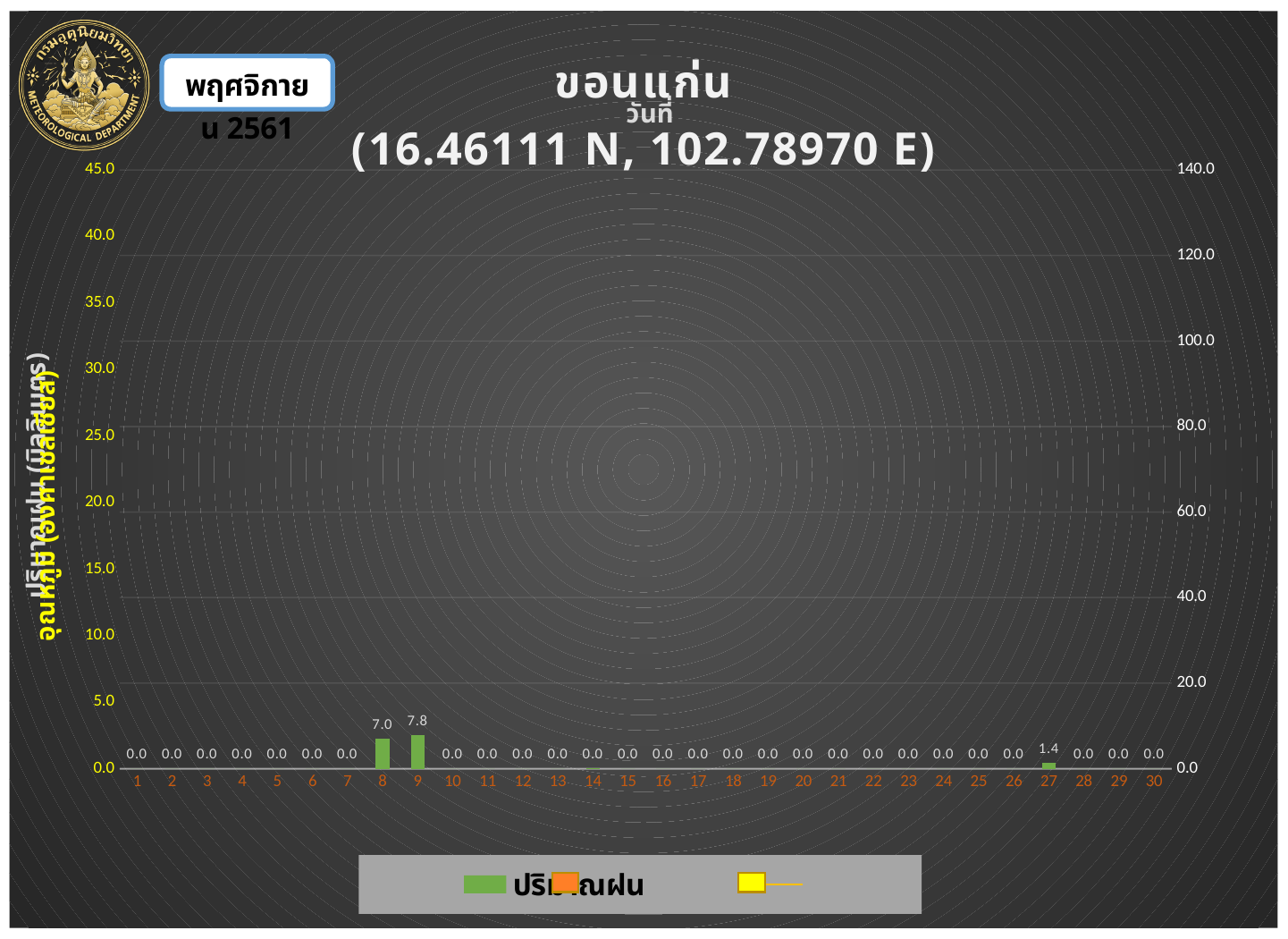
What is the difference between the rainfall values for day 8 and day 27? 5.6 What is the rainfall value shown for day 15? 0.0 What is the rainfall value shown for day 9? 7.8 What is the rainfall value shown for day 8? 7.0 What is the highest tick value shown on the right-hand axis? 140.0 Which day has the highest rainfall value? 9 What is the rainfall value shown for day 27? 1.4 What kind of chart is used to show the rainfall values? bar chart Is the rainfall value for day 9 greater or less than 10.0 on the left axis? less How many days are shown on the x axis? 30 What is the difference between the rainfall values for day 9 and day 8? 0.8 Which is larger, the rainfall value for day 8 or for day 27? day 8